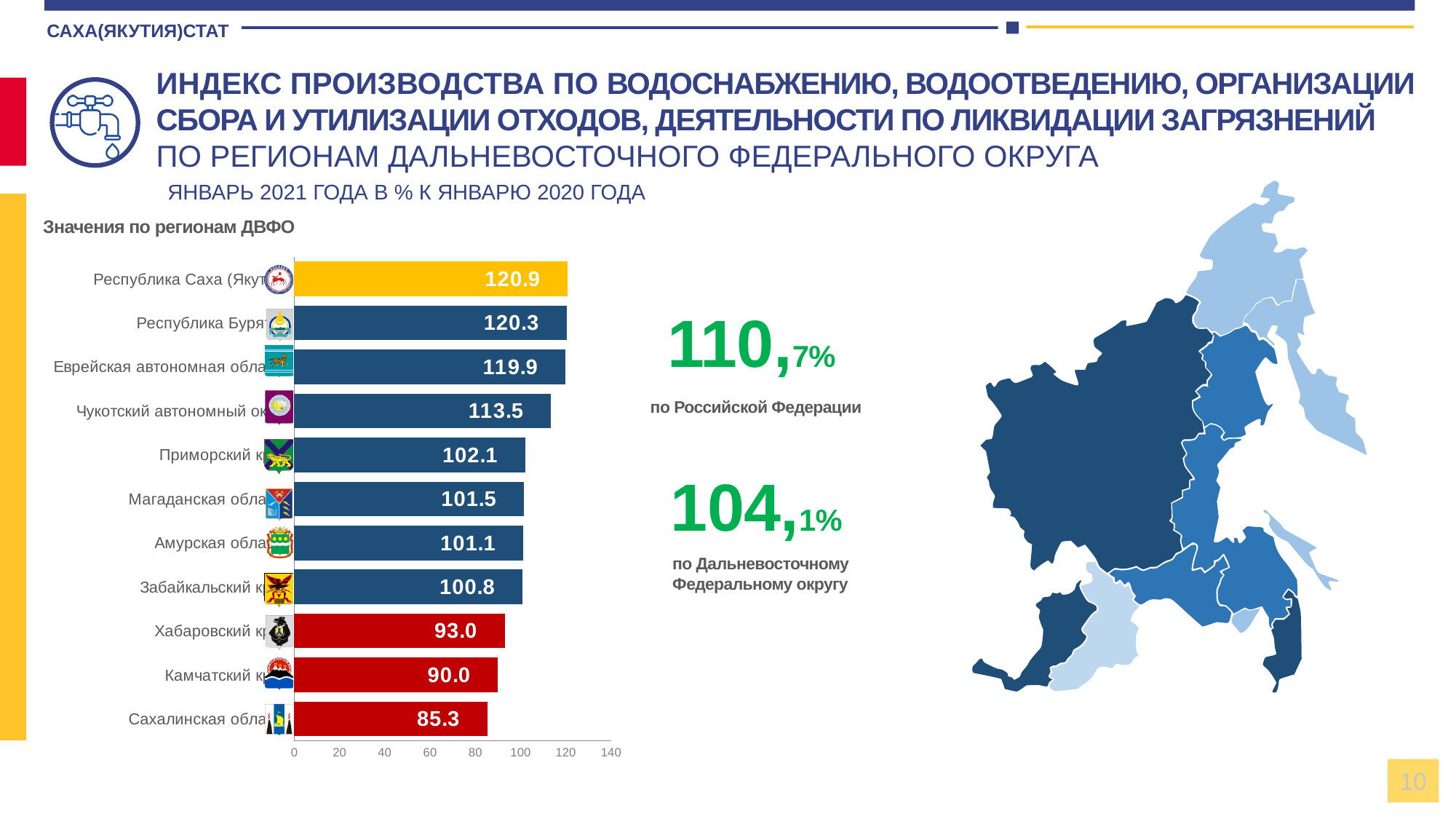
Which region has the highest value? Республика Саха (Якутия) Which region has the lowest value? Сахалинская область Which is larger, the value for Приморский край or the value for Камчатский край? Приморский край How many regions are shown in the bar chart? 11 What is the value for Республика Саха (Якутия)? 120.9 What is the difference between the values for Республика Саха (Якутия) and Сахалинская область? 35.6 What is the value for Магаданская область? 101.5 What is the difference between the values for Еврейская автономная область and Амурская область? 18.8 What is the value for Чукотский автономный округ? 113.5 What kind of chart is shown on the slide? Bar chart What colour are the bars for regions with values below 100? Red What is the value for Хабаровский край? 93.0